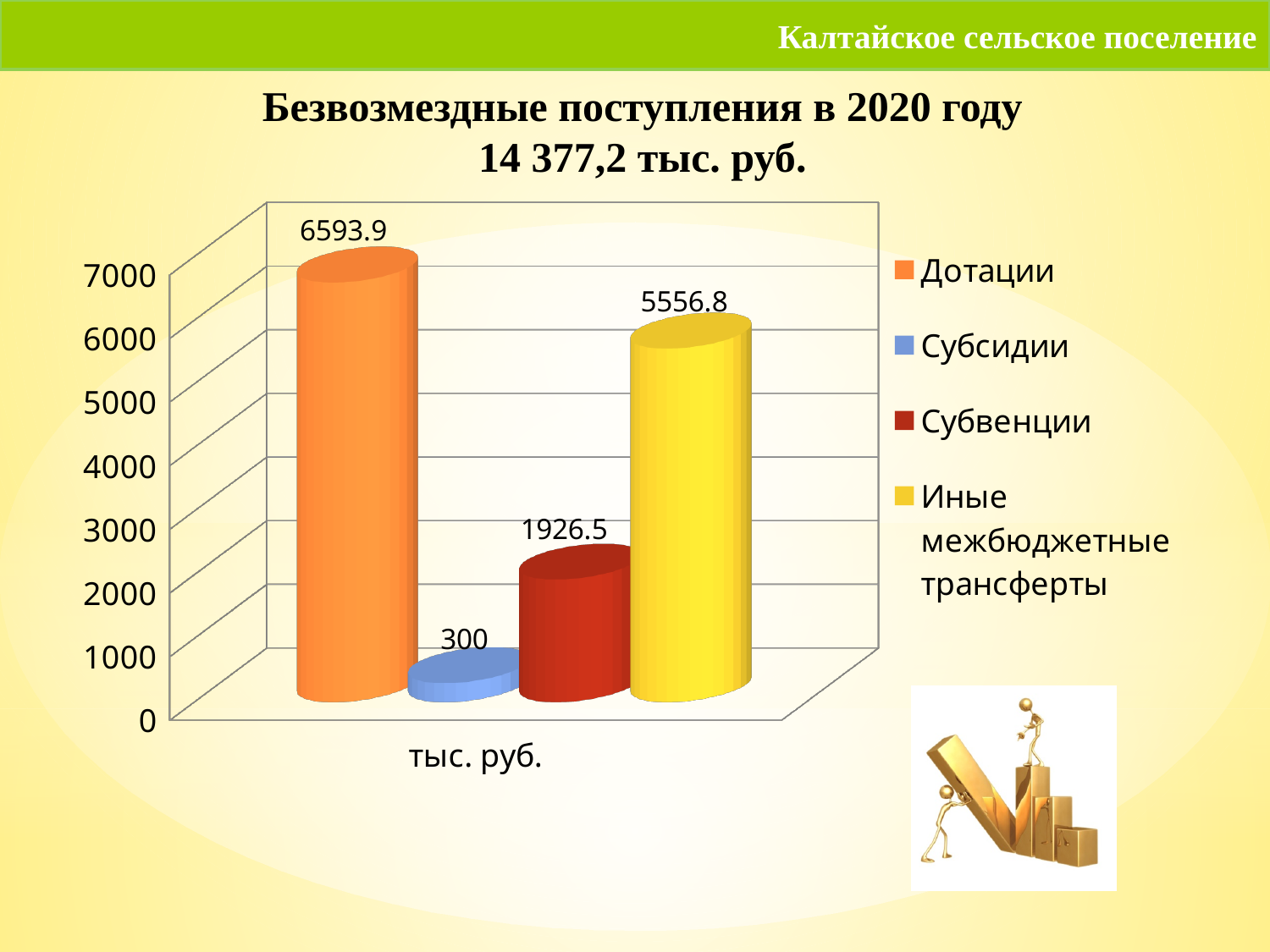
What is the value for Иные межбюджетные трансферты? 5556.8 What total amount is stated in the chart title? 14 377,2 тыс. руб. Which series has the highest value? Дотации Is the value for Иные межбюджетные трансферты greater or less than 5000? greater How many series does the legend list? 4 What is the value for Субсидии? 300 What is the value for Дотации? 6593.9 What is the value for Субвенции? 1926.5 Which series has the lowest value? Субсидии Which is larger, the value for Субвенции or the value for Субсидии? Субвенции What is the difference between the values for Дотации and Иные межбюджетные трансферты? 1037.1 What kind of chart is shown on the slide? bar chart